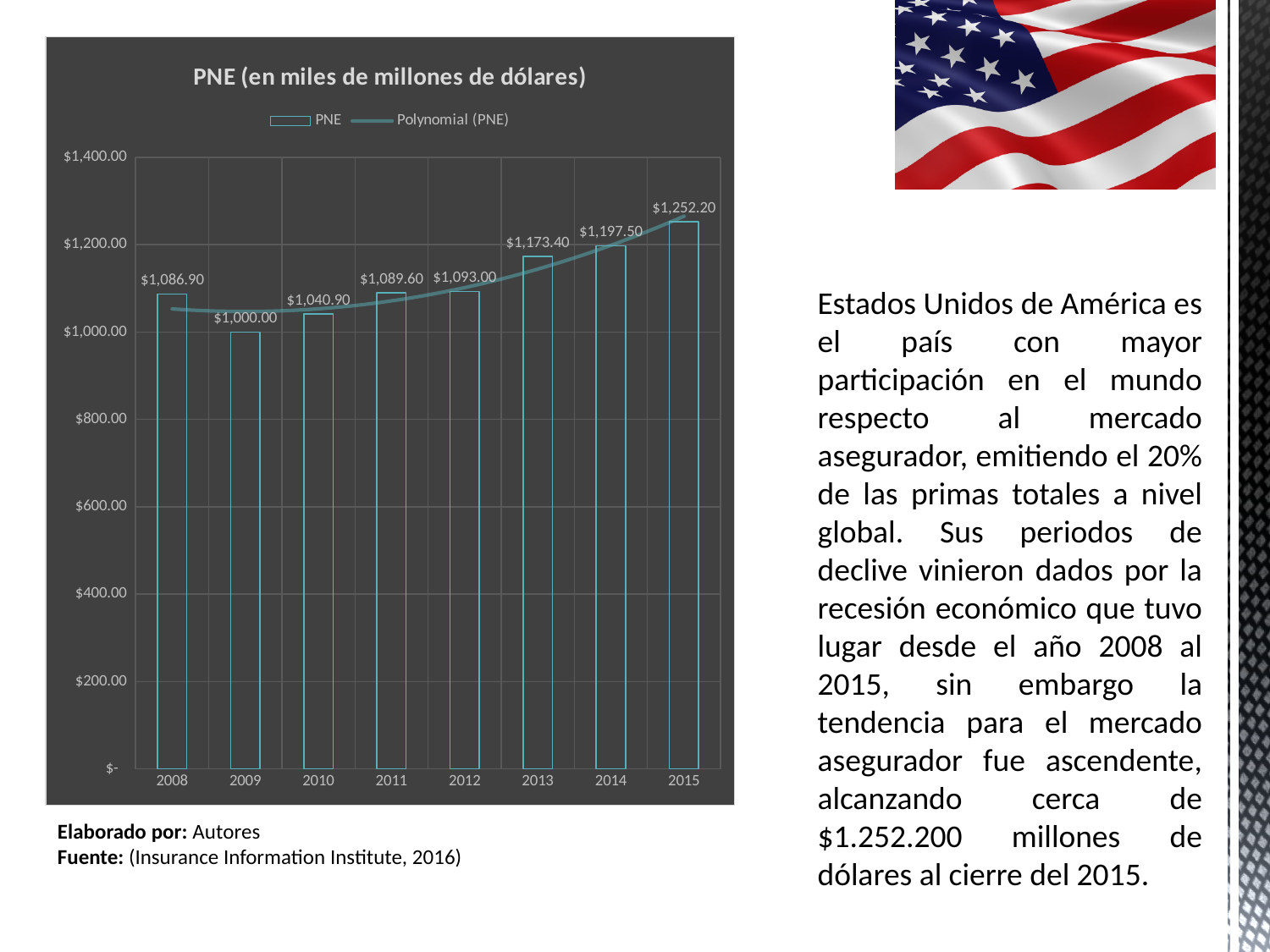
What is the PNE value for 2014? $1,197.50 Which year has a larger PNE value, 2010 or 2011? 2011 Is the PNE value for 2013 greater or less than $1,200.00? less Which year has the highest PNE value? 2015 What is the title of the chart? PNE (en miles de millones de dólares) How many years are shown on the x axis? 8 What kind of chart is shown? bar chart What is the PNE value for 2012? $1,093.00 What is the PNE value for 2008? $1,086.90 What is the difference between the PNE values for 2013 and 2012? $80.40 Which year has the lowest PNE value? 2009 What is the difference between the PNE values for 2015 and 2008? $165.30